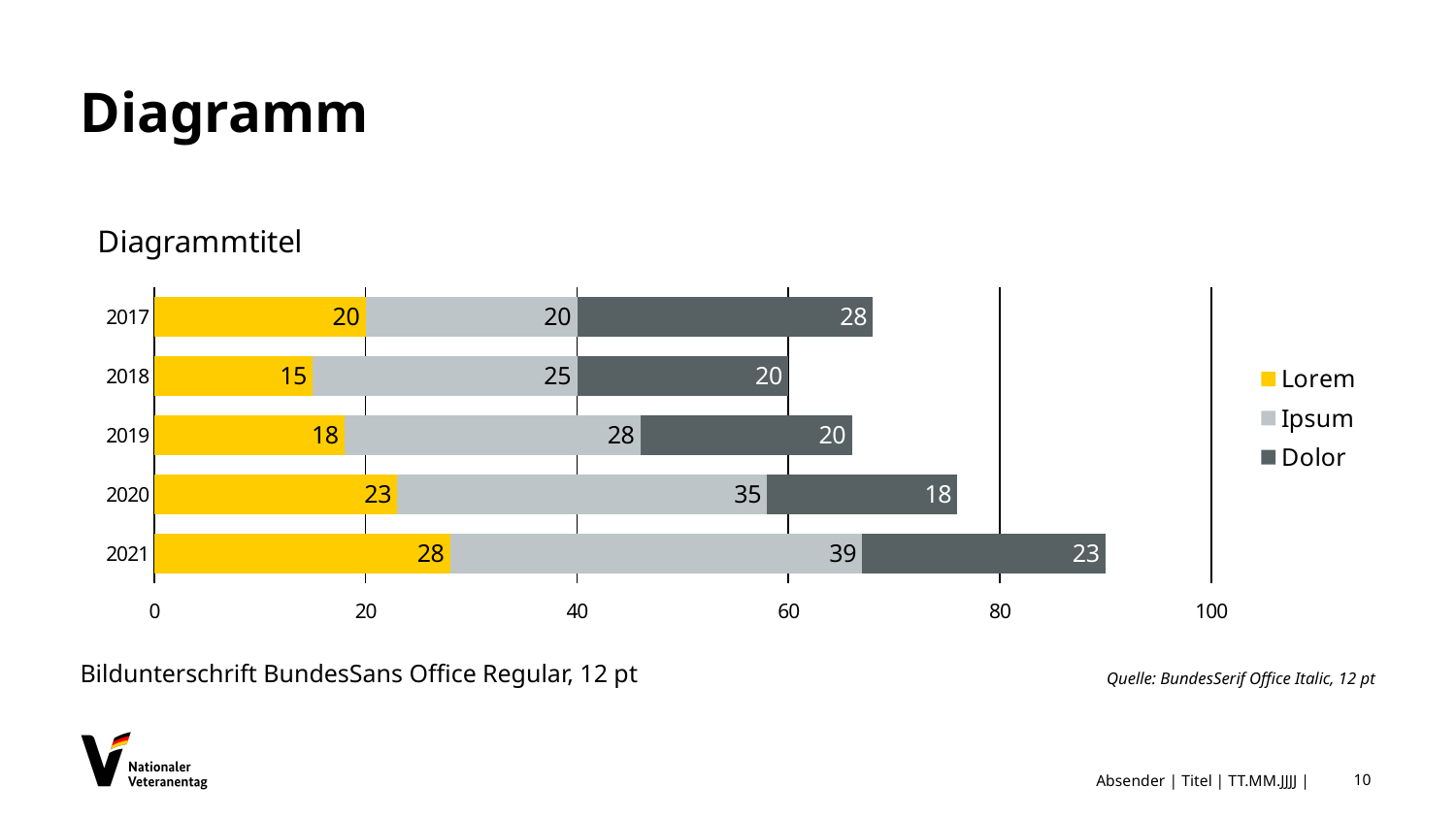
Which year has the highest Ipsum value? 2021 What kind of chart is shown on the slide? Stacked bar chart What is the Lorem value for 2018? 15 Which year has the lowest Lorem value? 2018 What is the Dolor value for 2017? 28 What is the Ipsum value for 2020? 35 How many series does the legend list? 3 Which is larger, the Dolor value for 2020 or the Dolor value for 2021? 2021 What is the title of the chart? Diagrammtitel How many categories (years) are shown on the chart? 5 What is the total of the stacked bar for 2021? 90 What is the difference between the Ipsum value for 2021 and the Ipsum value for 2017? 19